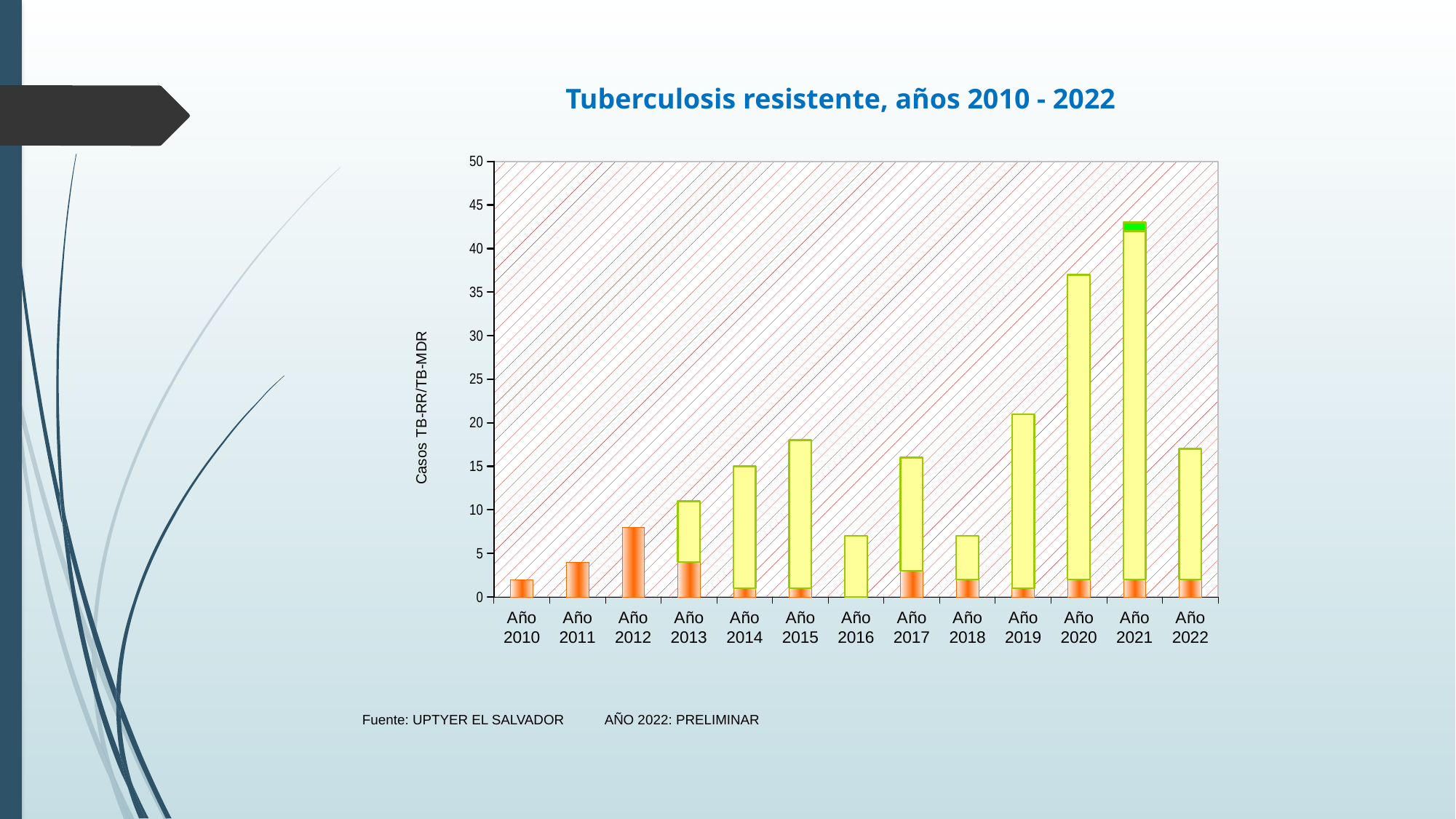
Which year has the tallest bar? Año 2021 Is the total value for Año 2021 greater or less than 40? greater What is the label on the vertical axis of the chart? Casos TB-RR/TB-MDR What is the title of the chart? Tuberculosis resistente, años 2010 - 2022 Is the value for Año 2010 greater or less than 5? less Is the total value for Año 2020 greater or less than 35? greater How many years (categories) are shown on the x axis? 13 Which year has the shortest bar? Año 2010 Which bar is taller, Año 2020 or Año 2019? Año 2020 What kind of chart is shown on the slide? bar chart